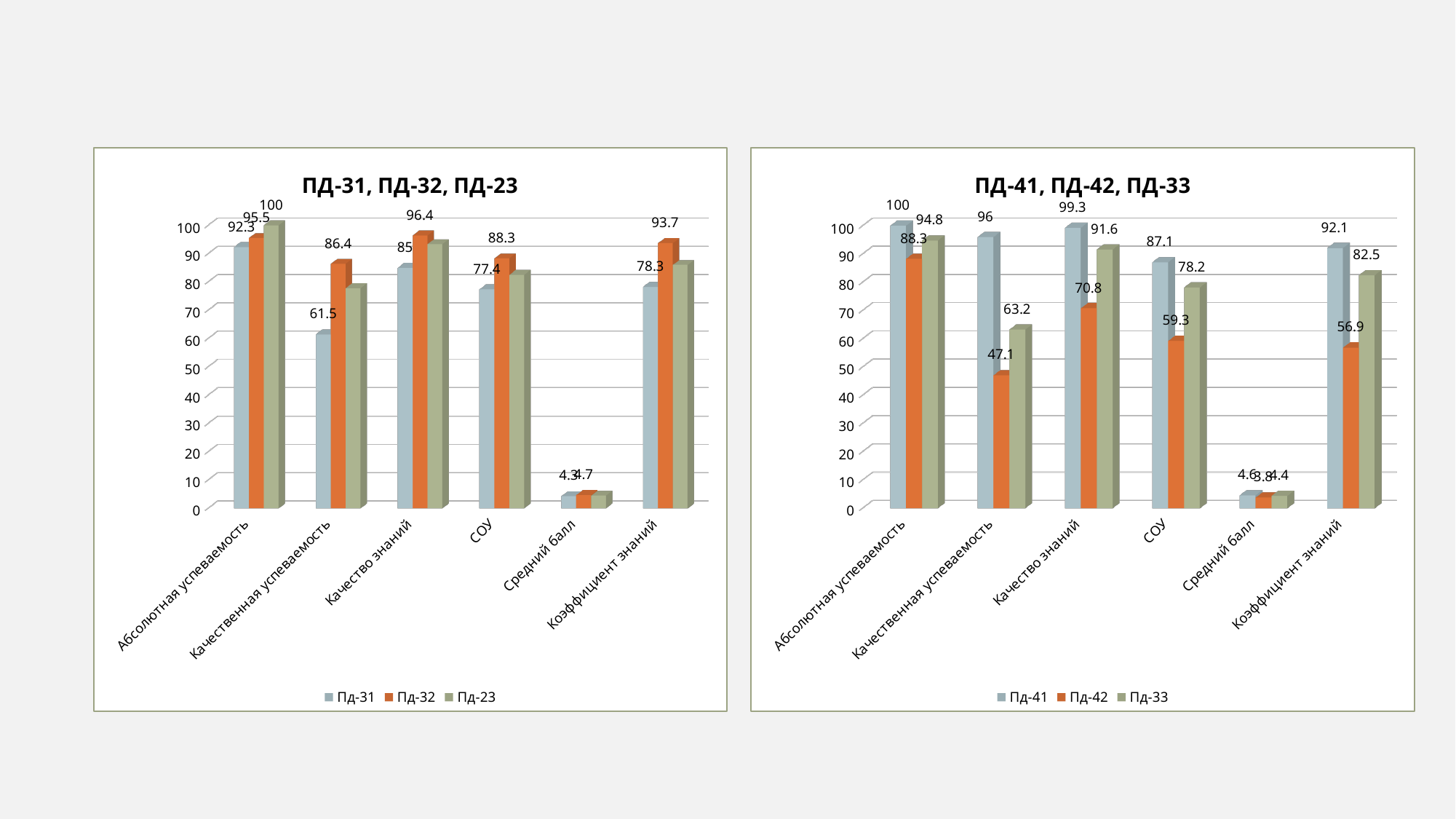
In the chart titled "ПД-31, ПД-32, ПД-23", is the value of Пд-23 for Качественная успеваемость greater or less than 70? greater How many categories are shown on the x axis of the chart titled "ПД-41, ПД-42, ПД-33"? 6 In the chart titled "ПД-31, ПД-32, ПД-23", what is the difference between Пд-32 and Пд-31 for Коэффициент знаний? 15.4 In the chart titled "ПД-41, ПД-42, ПД-33", what is the value of Пд-42 for Качественная успеваемость? 47.1 In the chart titled "ПД-31, ПД-32, ПД-23", what is the value of Пд-23 for Абсолютная успеваемость? 100 In the chart titled "ПД-31, ПД-32, ПД-23", what is the value of Пд-31 for СОУ? 77.4 In the chart titled "ПД-31, ПД-32, ПД-23", what is the value of Пд-32 for Качественная успеваемость? 86.4 In the chart titled "ПД-41, ПД-42, ПД-33", what is the difference between Пд-41 and Пд-42 for Абсолютная успеваемость? 11.7 In the chart titled "ПД-41, ПД-42, ПД-33", which is larger for Качество знаний: Пд-41 or Пд-33? Пд-41 How many series does the legend of the chart titled "ПД-31, ПД-32, ПД-23" list? 3 In the chart titled "ПД-41, ПД-42, ПД-33", what is the value of Пд-33 for Коэффициент знаний? 82.5 In the chart titled "ПД-41, ПД-42, ПД-33", which series has the lowest value for СОУ? Пд-42